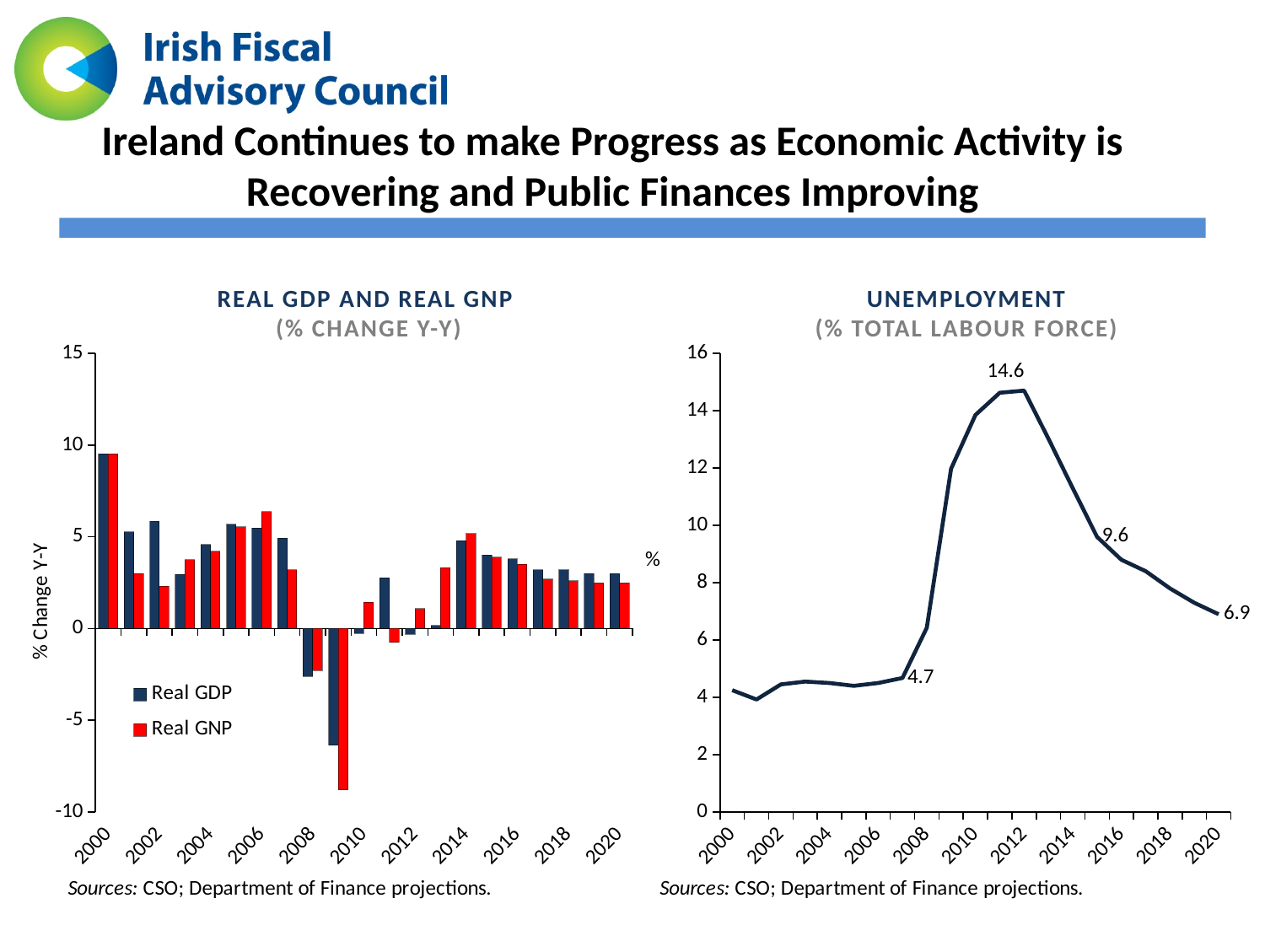
In the 'Real GDP and Real GNP' chart, which year has the lowest Real GNP value? 2009 What are the two series named in the legend of the 'Real GDP and Real GNP' chart? Real GDP and Real GNP In the 'Unemployment' chart, does the line rise or fall from 2012 to 2020? fall In the 'Unemployment' chart, what is the highest labelled value? 14.6 In the 'Unemployment' chart, is the value for 2010 greater or less than 10? greater In the 'Real GDP and Real GNP' chart, is the Real GDP value for 2000 greater or less than 5? greater In the 'Unemployment' chart, what is the labelled value at 2020? 6.9 In the 'Real GDP and Real GNP' chart, which series has the lower value in 2009, Real GDP or Real GNP? Real GNP What kind of chart is the 'Unemployment' chart on the right? line chart In the 'Unemployment' chart, what is the difference between the labelled peak of 14.6 and the 2020 value of 6.9? 7.7 How many series does the legend of the 'Real GDP and Real GNP' chart list? 2 What kind of chart is the 'Real GDP and Real GNP' chart on the left? bar chart